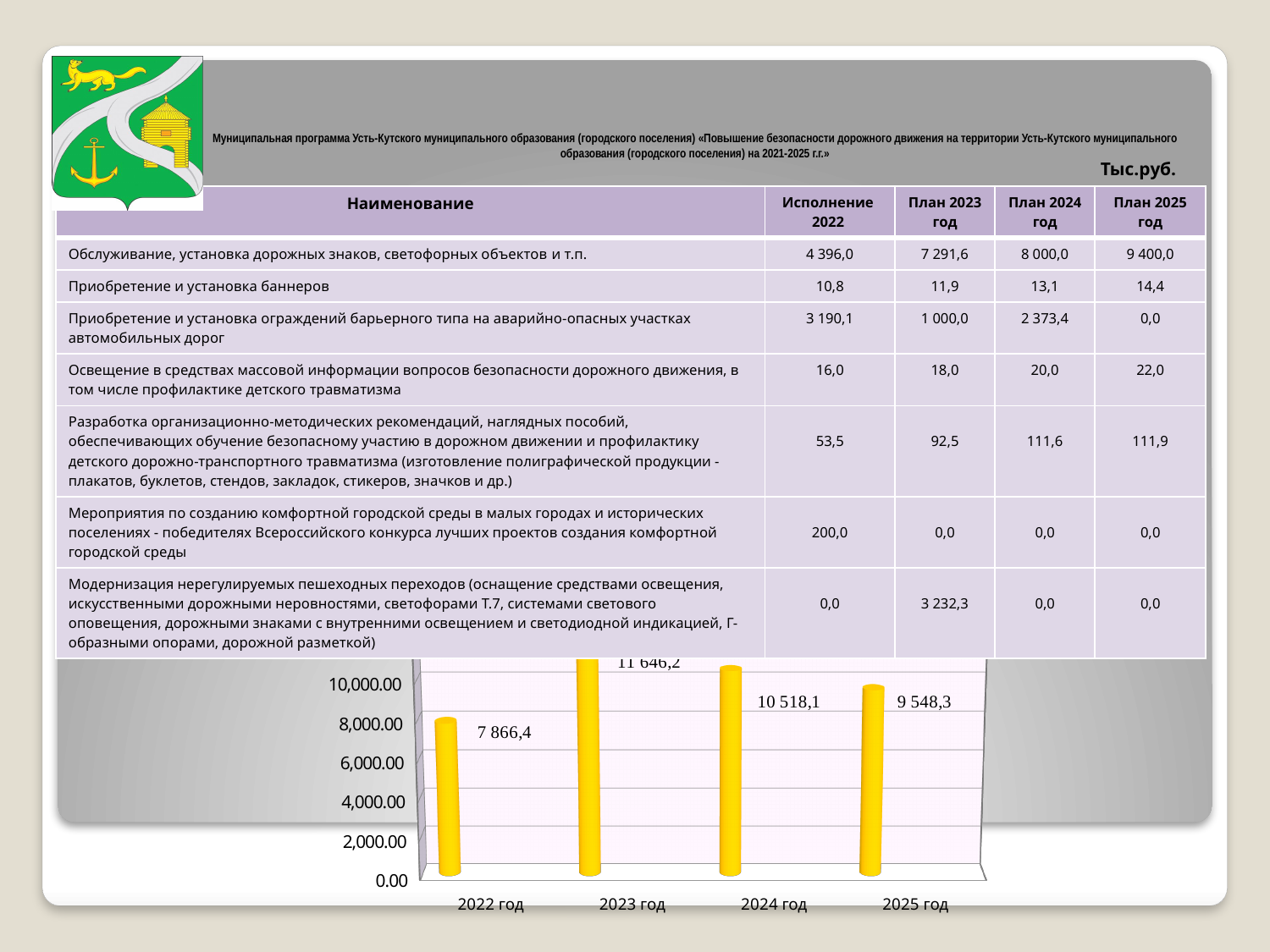
What type of chart is shown at the bottom of the slide? bar chart What is the value shown for 2023 год in the bar chart? 11 646,2 Which is larger in the bar chart, the value for 2024 год or 2025 год? 2024 год How many categories (years) are plotted in the bar chart? 4 What is the value shown for 2024 год in the bar chart? 10 518,1 Does the value in the bar chart rise or fall from 2023 год to 2025 год? fall What is the difference between the values for 2024 год and 2025 год in the bar chart? 969,8 Is the value for 2022 год in the bar chart greater or less than 8,000.00? less What is the value shown for 2025 год in the bar chart? 9 548,3 Which year has the highest value in the bar chart? 2023 год What is the value shown for 2022 год in the bar chart? 7 866,4 Which year has the lowest value in the bar chart? 2022 год